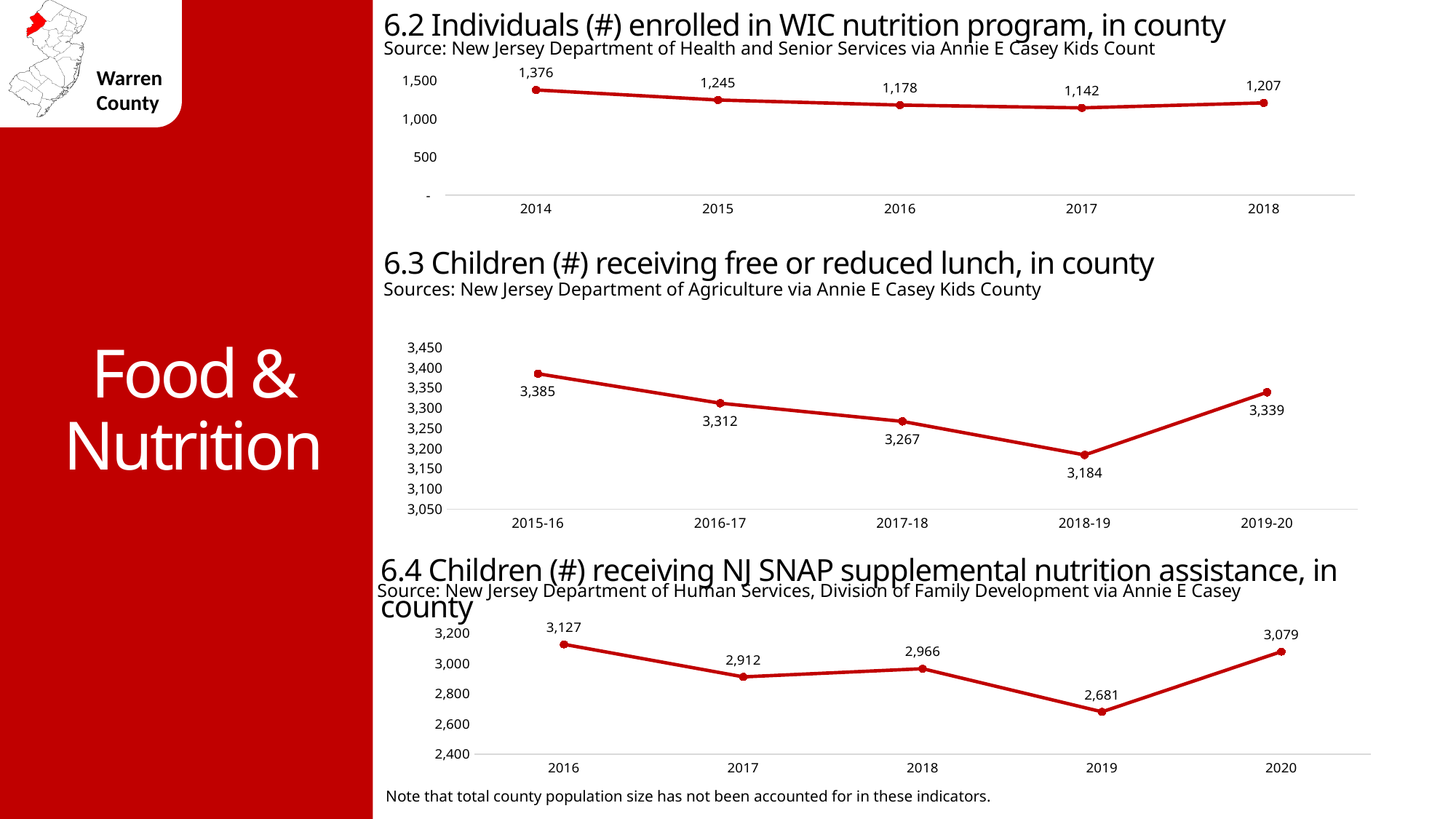
In the chart '6.3 Children (#) receiving free or reduced lunch, in county', which school year has the highest value? 2015-16 In the chart '6.3 Children (#) receiving free or reduced lunch, in county', what kind of chart is shown? Line chart In the chart '6.4 Children (#) receiving NJ SNAP supplemental nutrition assistance, in county', which year has the highest value? 2016 In the chart '6.2 Individuals (#) enrolled in WIC nutrition program, in county', what is the value for 2014? 1,376 In the chart '6.3 Children (#) receiving free or reduced lunch, in county', is the value for 2016-17 larger than the value for 2019-20? No In the chart '6.3 Children (#) receiving free or reduced lunch, in county', what is the value for 2018-19? 3,184 In the chart '6.2 Individuals (#) enrolled in WIC nutrition program, in county', which year has the lowest value? 2017 In the chart '6.4 Children (#) receiving NJ SNAP supplemental nutrition assistance, in county', what is the value for 2019? 2,681 In the chart '6.2 Individuals (#) enrolled in WIC nutrition program, in county', what is the difference between the 2014 and 2018 values? 169 In the chart '6.4 Children (#) receiving NJ SNAP supplemental nutrition assistance, in county', do the values rise or fall from 2019 to 2020? Rise In the chart '6.2 Individuals (#) enrolled in WIC nutrition program, in county', how many years are plotted? 5 In the chart '6.4 Children (#) receiving NJ SNAP supplemental nutrition assistance, in county', what is the difference between the 2020 and 2019 values? 398